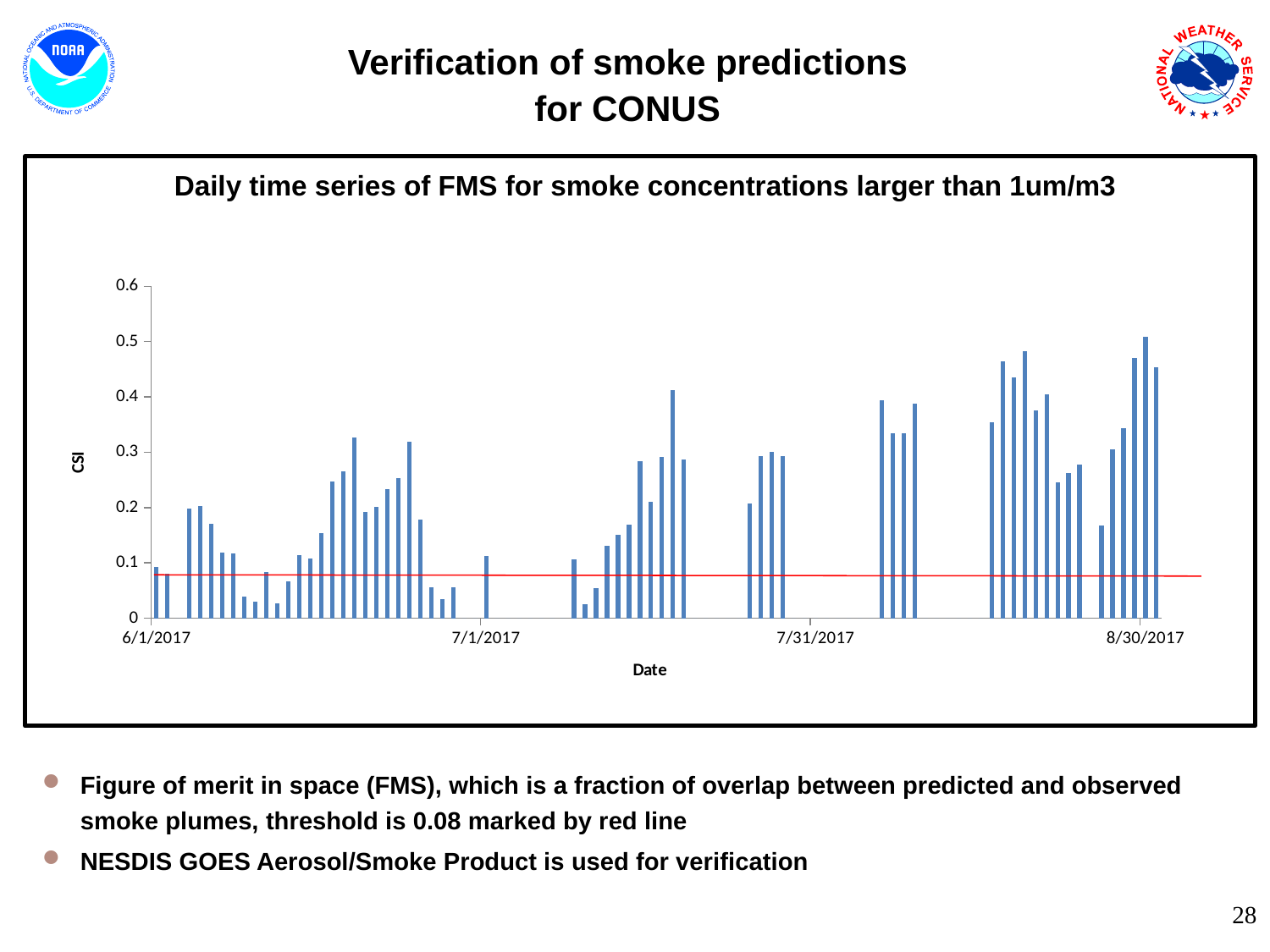
Is the value for 8/30/2017 greater or less than 0.3? greater Is the value for 7/1/2017 greater or less than 0.2? less Which of the two dates has the larger value, 7/1/2017 or 8/30/2017? 8/30/2017 Is the value for 6/1/2017 greater or less than 0.2? less Which of the two dates has the larger value, 6/1/2017 or 8/30/2017? 8/30/2017 What label is shown on the vertical axis of the chart? CSI What is the title of the chart? Daily time series of FMS for smoke concentrations larger than 1um/m3 How many date labels are shown along the horizontal axis of the chart? 4 What is the highest value shown on the vertical axis of the chart? 0.6 What kind of chart is shown on the slide? bar chart